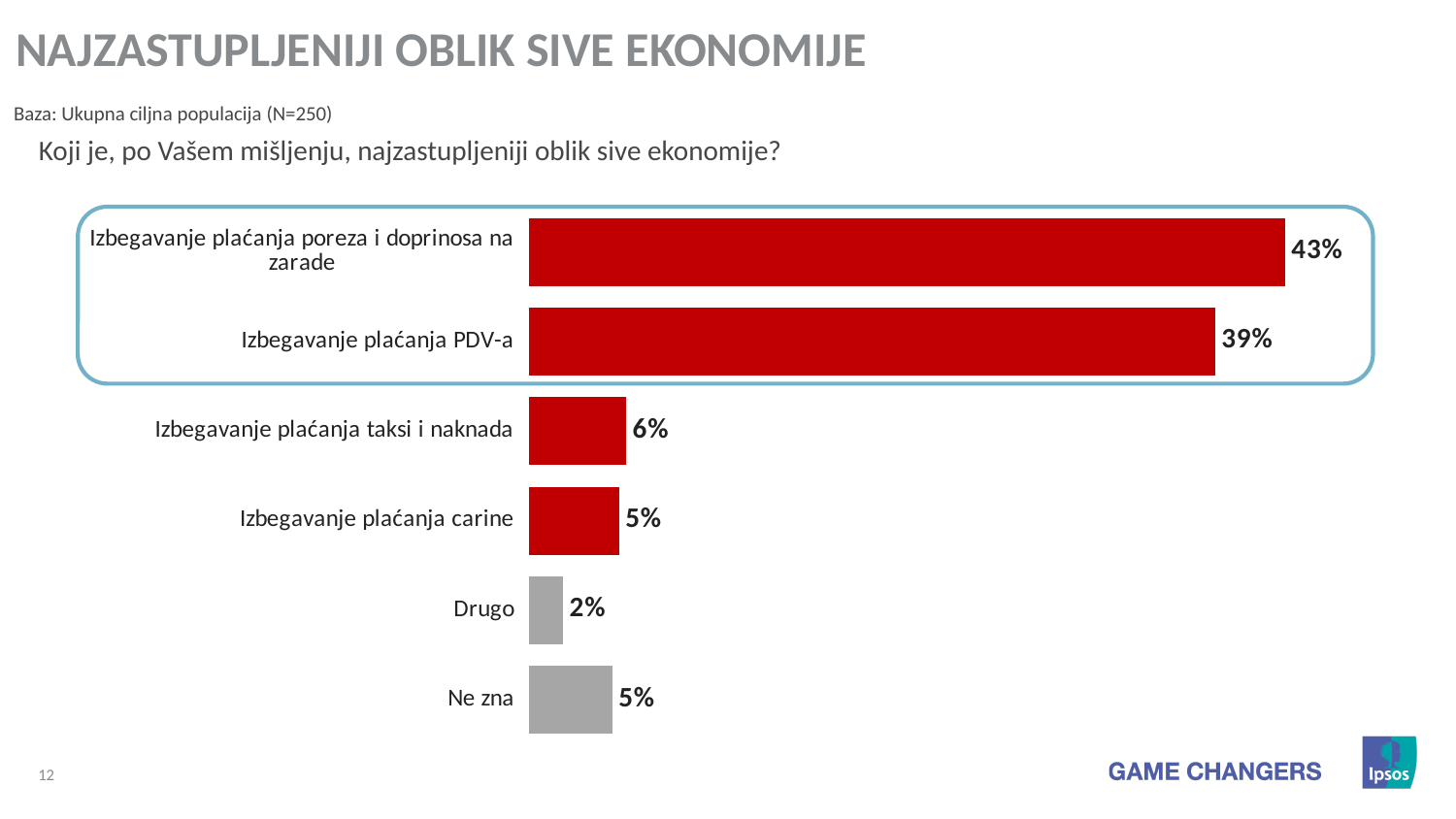
What kind of chart is shown on the slide? Bar chart What is the value for "Izbegavanje plaćanja PDV-a"? 39% What is the value for "Ne zna"? 5% Which category has the lowest value? Drugo What is the difference between the values for "Izbegavanje plaćanja poreza i doprinosa na zarade" and "Izbegavanje plaćanja PDV-a"? 4% Which is larger, the value for "Izbegavanje plaćanja taksi i naknada" or the value for "Izbegavanje plaćanja carine"? Izbegavanje plaćanja taksi i naknada Which category has the highest value? Izbegavanje plaćanja poreza i doprinosa na zarade How many categories are shown in the chart? 6 What is the value for "Izbegavanje plaćanja poreza i doprinosa na zarade"? 43% What is the value for "Drugo"? 2% What is the title of the slide containing the chart? NAJZASTUPLJENIJI OBLIK SIVE EKONOMIJE What is the value for "Izbegavanje plaćanja taksi i naknada"? 6%